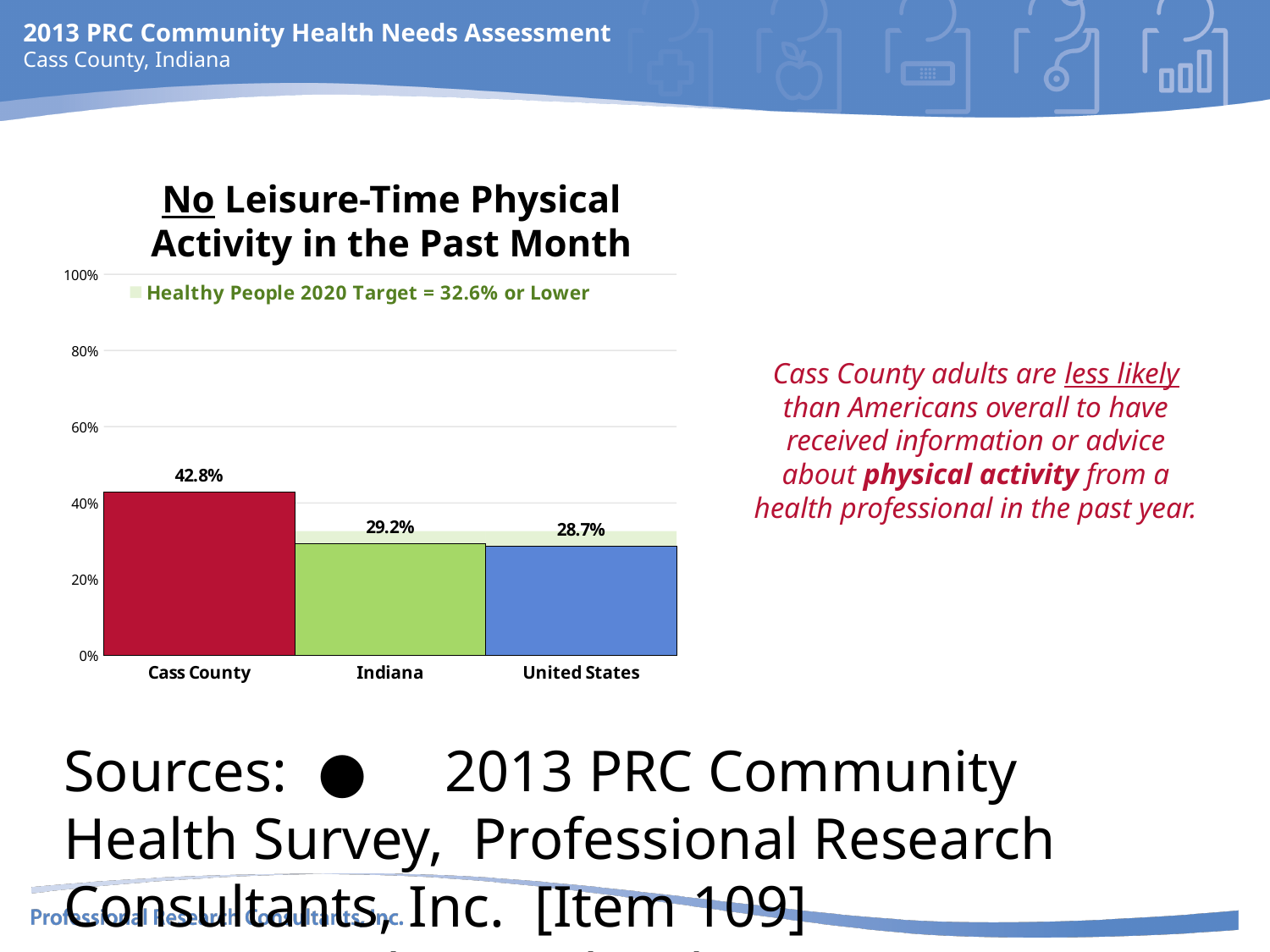
Which category has the highest value? Cass County What is the value for United States? 28.7% Is the value for Cass County greater or less than 40%? greater Which is larger, the value for Cass County or the value for United States? Cass County What is the Healthy People 2020 Target shown in the chart legend? 32.6% or Lower How many categories are shown on the x axis? 3 What is the difference between the Cass County value and the Indiana value? 13.6% What is the value for Indiana? 29.2% What is the difference between the Cass County value and the United States value? 14.1% What kind of chart is shown on the slide? bar chart What is the value for Cass County? 42.8% Which category has the lowest value? United States